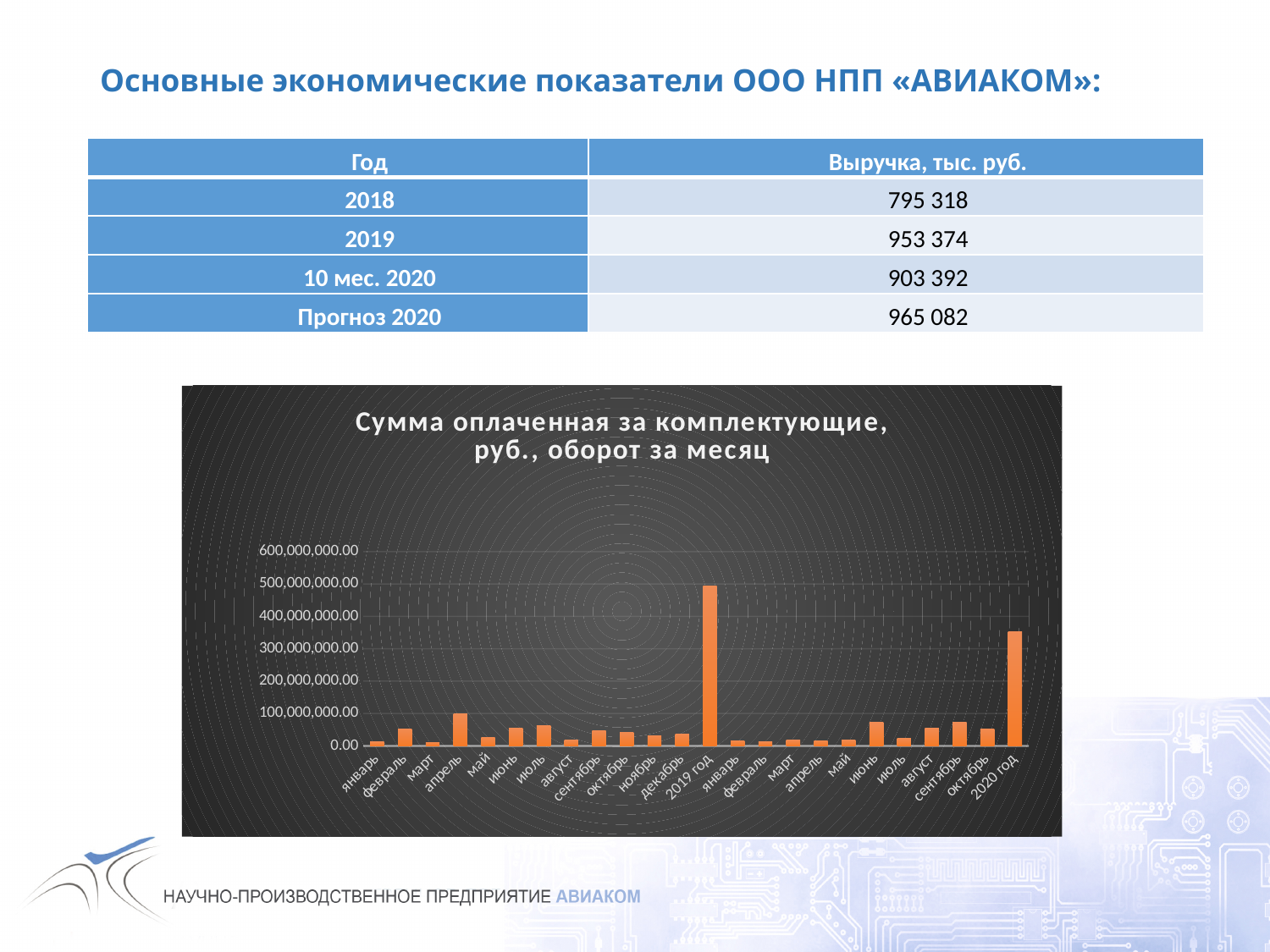
Is the value for 2020 год greater or less than 400,000,000.00? less What is the title of the chart? Сумма оплаченная за комплектующие, руб., оборот за месяц Is the value for the second июнь (2020) greater or less than 100,000,000.00? less Which is larger, the value for 2019 год or the value for 2020 год? 2019 год What is the highest tick value shown on the vertical axis of the chart? 600,000,000.00 Is the value for 2019 год greater or less than 400,000,000.00? greater Which category has the highest bar in the chart? 2019 год Which is larger, the value for the first апрель or the value for the first май? апрель What kind of chart is shown on the slide? bar chart How many categories are plotted along the x axis of the chart? 24